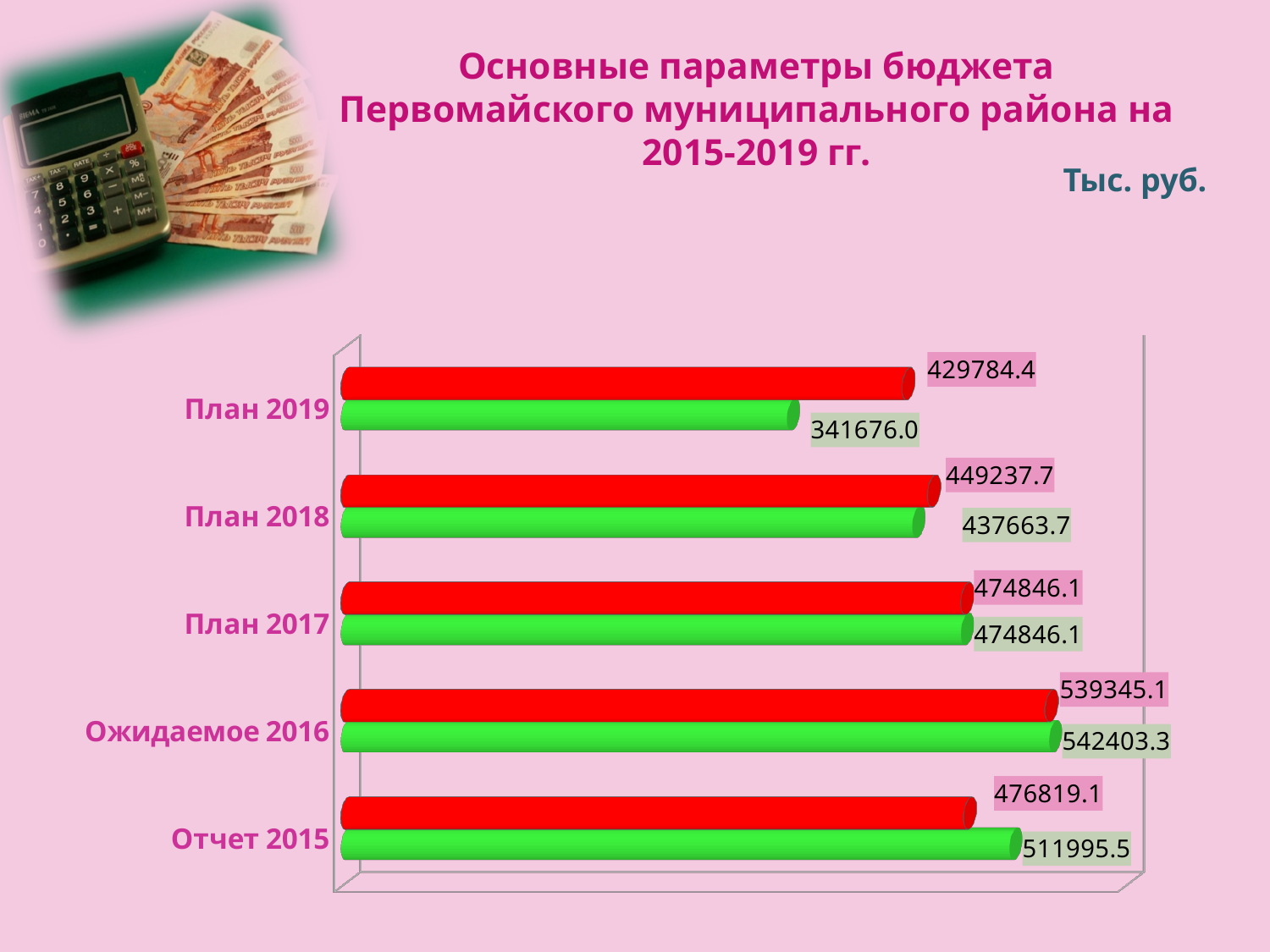
What type of chart is shown on the slide? bar chart Which category has the highest red bar value? Ожидаемое 2016 What is the difference between the green and red bar values for Отчет 2015? 35176.4 Which category has the lowest red bar value? План 2019 What is the difference between the red and green bar values for План 2019? 88108.4 What is the value of the red bar for План 2019? 429784.4 What is the value of the green bar for План 2017? 474846.1 Which category has the lowest green bar value? План 2019 What is the value of the green bar for Отчет 2015? 511995.5 For План 2018, which bar has the larger value, the red or the green? red How many categories are shown on the chart? 5 Which category has the highest green bar value? Ожидаемое 2016